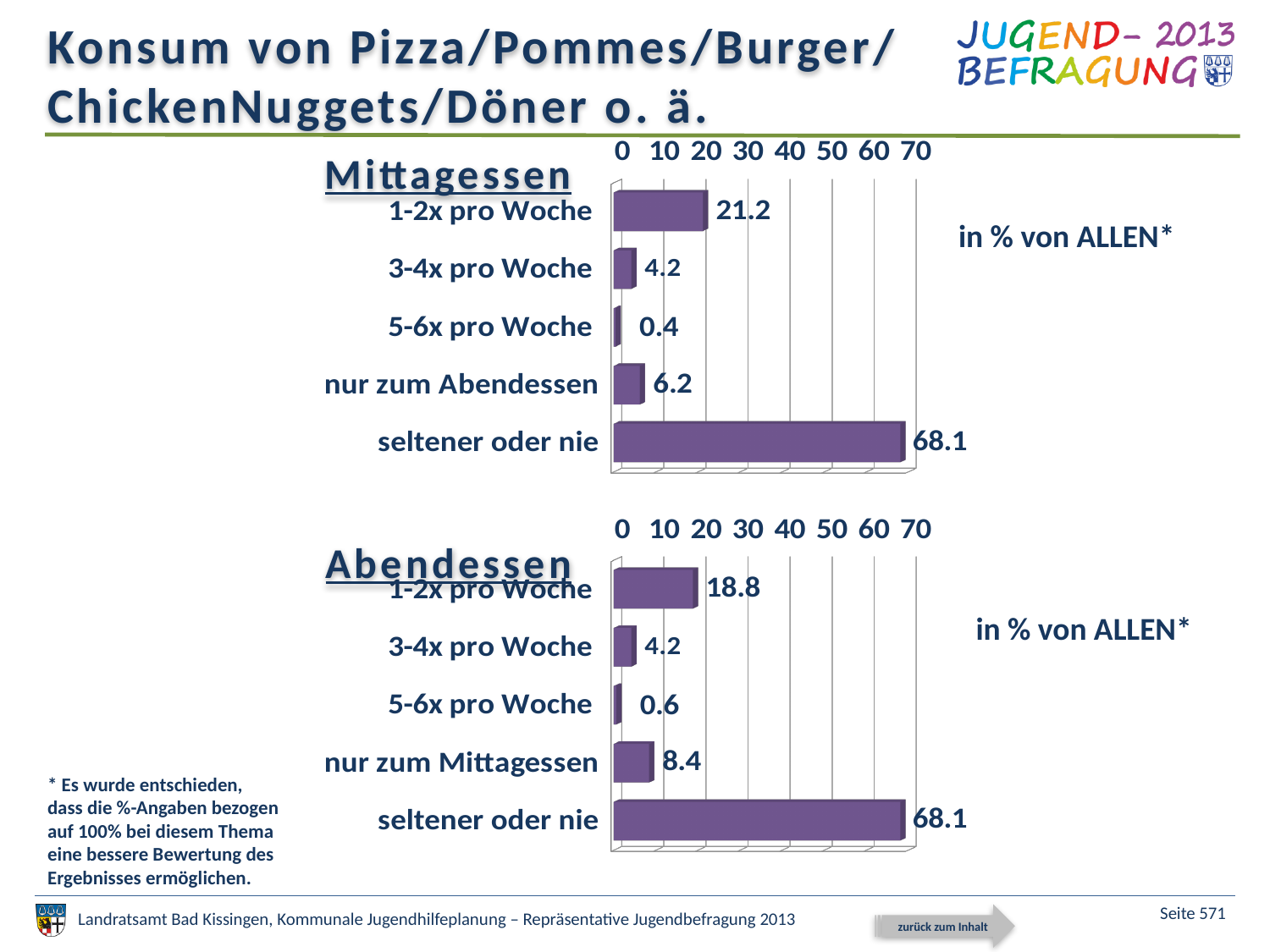
In the Abendessen chart, which category has the lowest value? 5-6x pro Woche What is the highest tick value shown on the x axis of the Mittagessen chart? 70 In the Mittagessen chart, what is the value for '1-2x pro Woche'? 21.2 Which is larger: '1-2x pro Woche' in the Mittagessen chart or '1-2x pro Woche' in the Abendessen chart? Mittagessen (21.2) What type of chart is the Mittagessen chart? bar chart In the Abendessen chart, what is the difference between '1-2x pro Woche' and '3-4x pro Woche'? 14.6 In the Mittagessen chart, what is the difference between 'seltener oder nie' and '1-2x pro Woche'? 46.9 How many categories does the Abendessen chart show? 5 In the Abendessen chart, what is the value for '5-6x pro Woche'? 0.6 In the Mittagessen chart, which category has the highest value? seltener oder nie In the Mittagessen chart, is the value for 'seltener oder nie' greater or less than 60? greater In the Abendessen chart, what is the value for 'nur zum Mittagessen'? 8.4